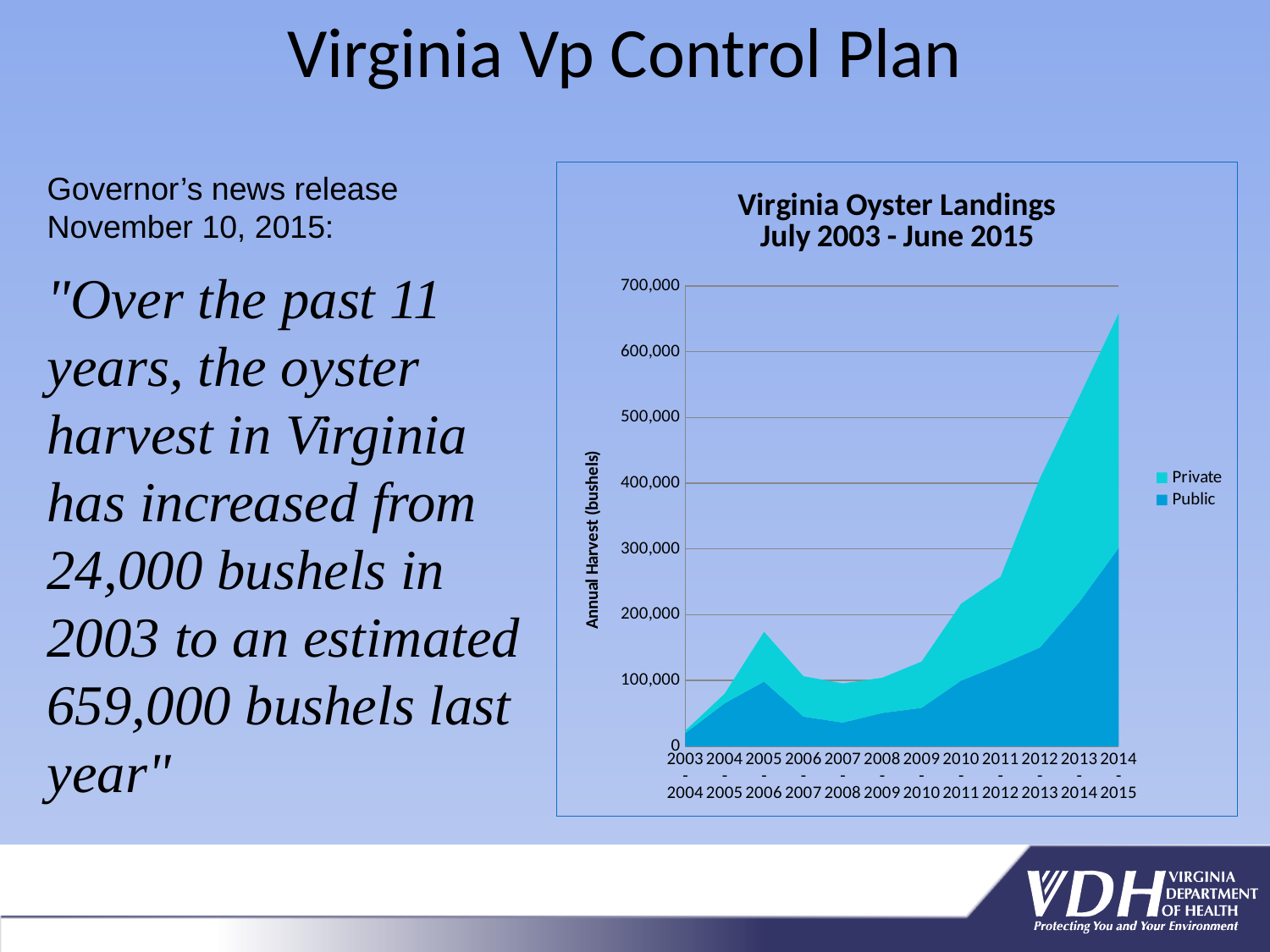
Which harvest period has the highest total oyster landings in the chart? 2014-2015 Overall, do total oyster landings rise or fall from 2003-2004 to 2014-2015? rise How many harvest periods are shown along the x axis of the chart? 12 Is the total harvest for 2014-2015 greater or less than 600,000 bushels? greater How many series does the legend of the chart list? 2 What is the title of the chart? Virginia Oyster Landings July 2003 - June 2015 What kind of chart is shown on the slide? Stacked area chart Which harvest period has the lowest total oyster landings in the chart? 2003-2004 Is the Public harvest for 2007-2008 greater or less than 100,000 bushels? less Is the total harvest for 2003-2004 greater or less than 100,000 bushels? less What is the label on the vertical axis of the chart? Annual Harvest (bushels)